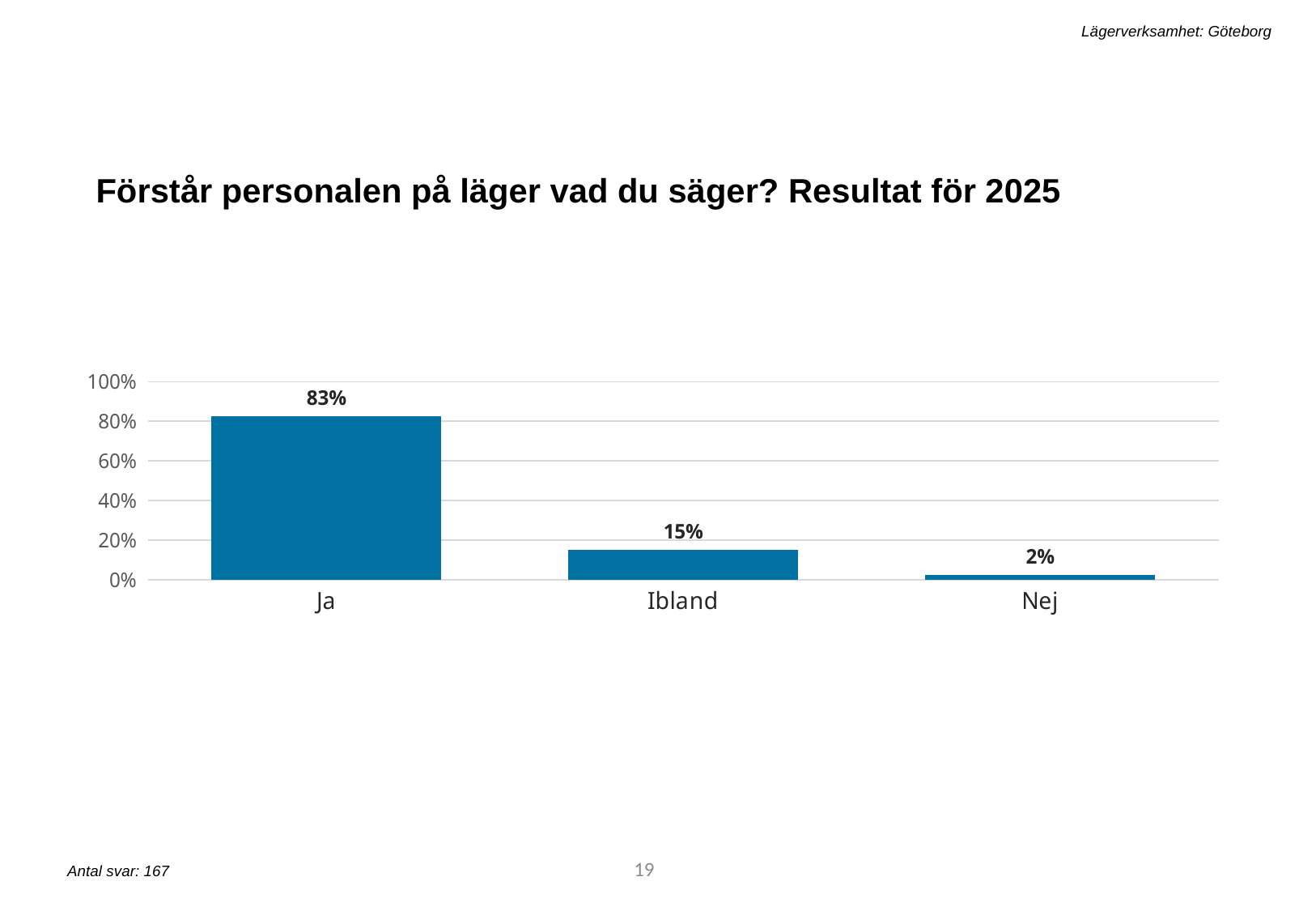
How many categories are shown on the x axis? 3 What kind of chart is shown on the slide? bar chart What is the value for Ibland? 15% Which is larger, the value for Ibland or the value for Nej? Ibland What is the value for Nej? 2% What is the value for Ja? 83% Which category has the highest value? Ja Is the value for Ja greater or less than 60%? greater What is the difference between the values for Ja and Ibland? 68% Which category has the lowest value? Nej What is the title of the chart? Förstår personalen på läger vad du säger? Resultat för 2025 What is the difference between the values for Ibland and Nej? 13%